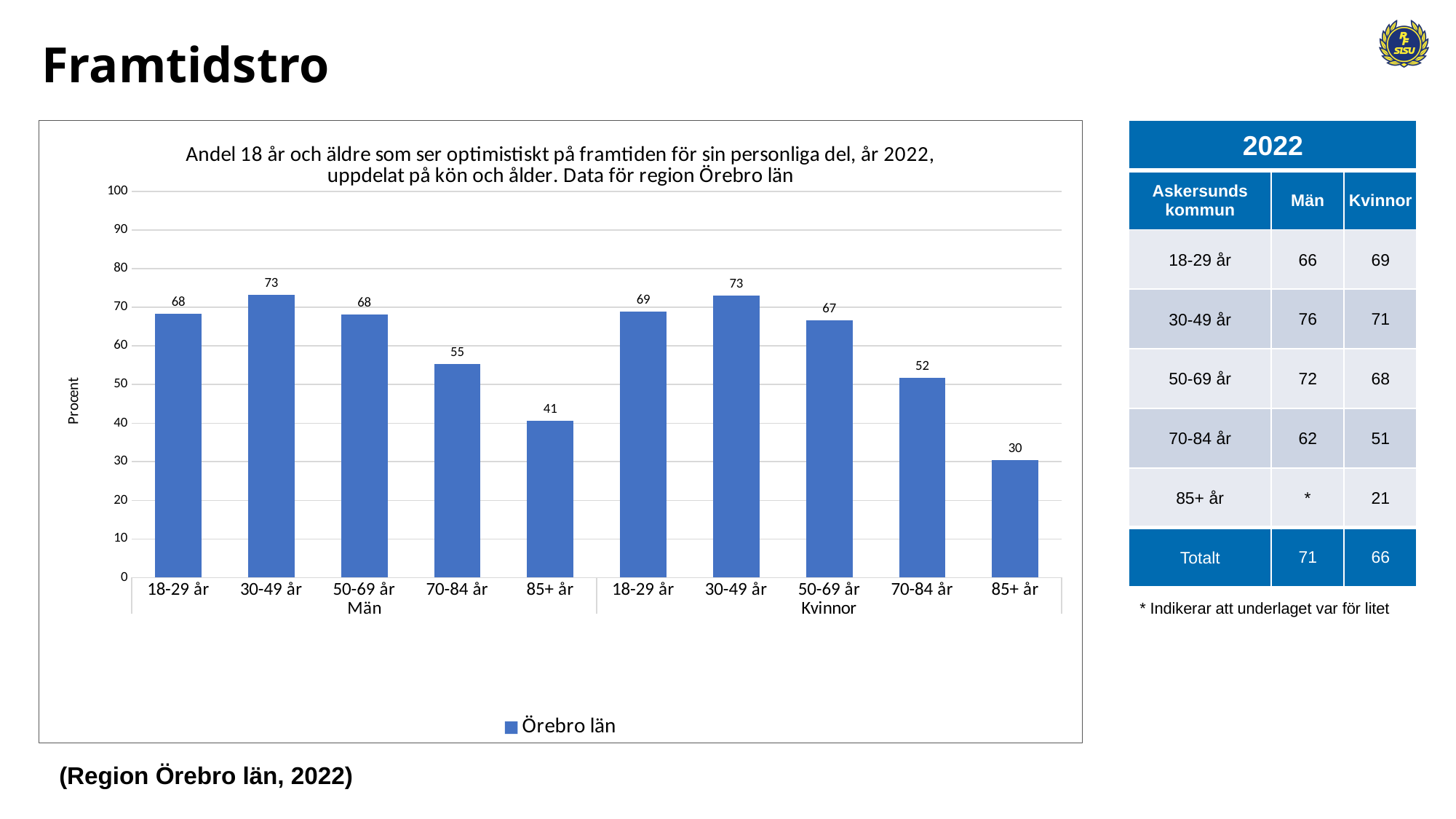
What is the value for 30-49 år among Män? 73 Which age group among Män has the highest value? 30-49 år What is the value for 18-29 år among Kvinnor? 69 What is the label of the series in the chart legend? Örebro län What kind of chart is shown on the slide? bar chart What is the value for 70-84 år among Män? 55 What is the value for 85+ år among Kvinnor? 30 How many series does the legend list? 1 How many bars are plotted in the chart? 10 Which is larger: the value for 70-84 år among Män or 70-84 år among Kvinnor? 70-84 år among Män What is the difference between the values for 85+ år among Män and 85+ år among Kvinnor? 11 Which age group among Kvinnor has the lowest value? 85+ år